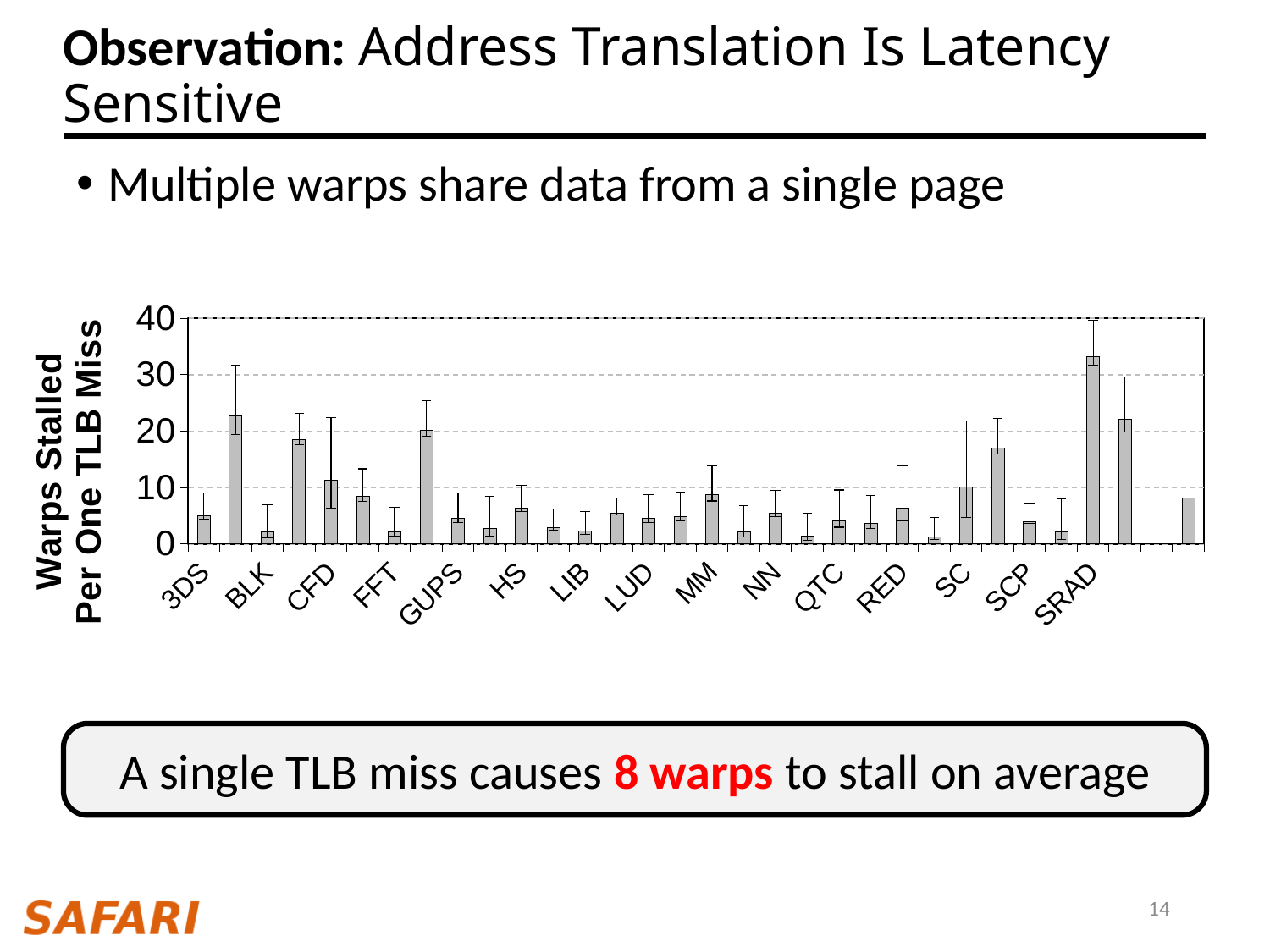
What is the label of the y axis of the chart? Warps Stalled Per One TLB Miss How many category labels are printed along the x axis of the chart? 15 What kind of chart is shown on the slide? bar chart According to the slide, how many warps does a single TLB miss cause to stall on average? 8 warps What is the highest tick value shown on the y axis? 40 Is the tallest bar in the chart greater or less than 30? greater Is the tallest bar in the chart greater or less than 40? less Is the value for 3DS greater or less than 10? less